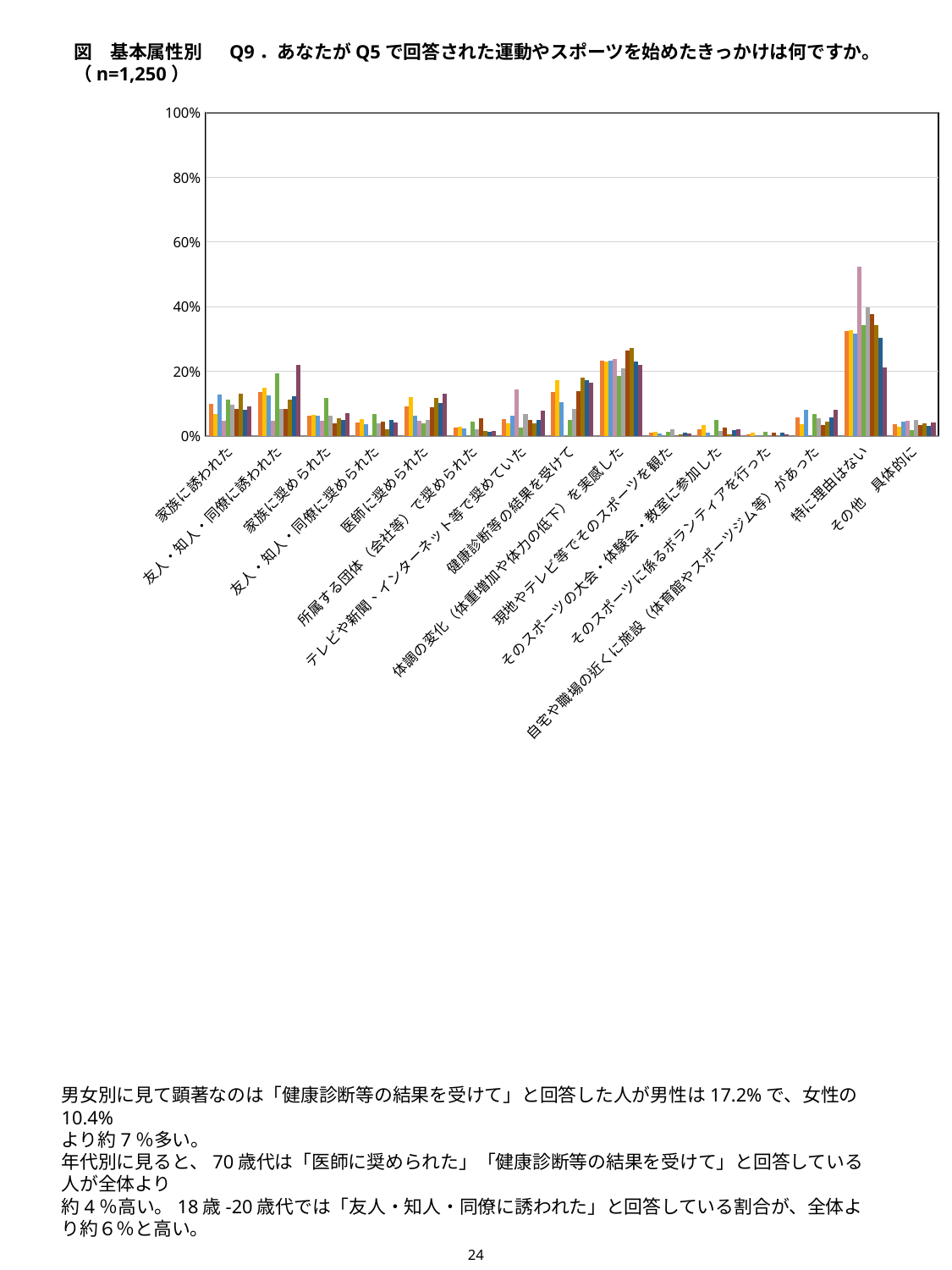
Are all the bars for 家族に誘われた greater or less than 20%? less Are all the bars for 体調の変化（体重増加や体力の低下）を実感した greater or less than 40%? less How many categories are shown along the x axis of the chart? 15 What sample size (n) is stated in the chart title? n=1,250 Which category has the tallest bars in the chart? 特に理由はない What is the maximum value shown on the chart's vertical axis? 100% Are all the bars for そのスポーツに係るボランティアを行った greater or less than 20%? less Which category has higher bars overall: 特に理由はない or 家族に誘われた? 特に理由はない Which category has higher bars overall: 体調の変化（体重増加や体力の低下）を実感した or そのスポーツに係るボランティアを行った? 体調の変化（体重増加や体力の低下）を実感した What kind of chart is shown on the slide? bar chart